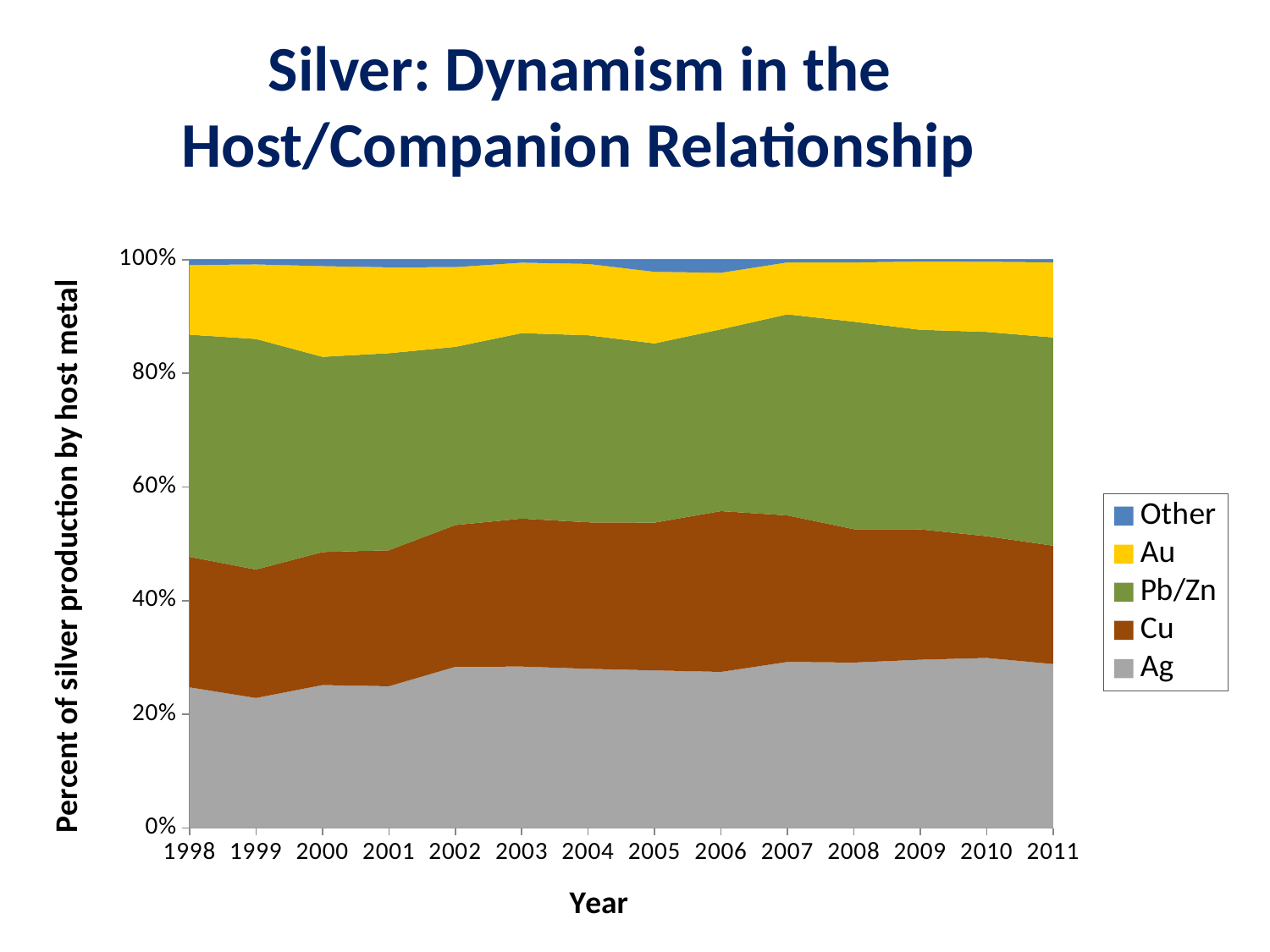
Is the value for Ag in 2011 greater or less than 20%? greater Does the share of silver production from Ag hosts rise or fall overall from 1998 to 2011? rise How many years are plotted along the x axis? 14 What kind of chart is shown on the slide? Stacked area chart What is the last year shown on the x axis? 2011 Which host metal accounts for the largest share of silver production in 1998? Pb/Zn Is the value for Ag in 2010 greater or less than 40%? less Which series accounts for the smallest share of silver production across the years shown? Other How many series does the legend list? 5 What is the first year shown on the x axis? 1998 In 2011, which is larger, the share for Ag or the share for Cu? Ag What is the label on the y axis? Percent of silver production by host metal